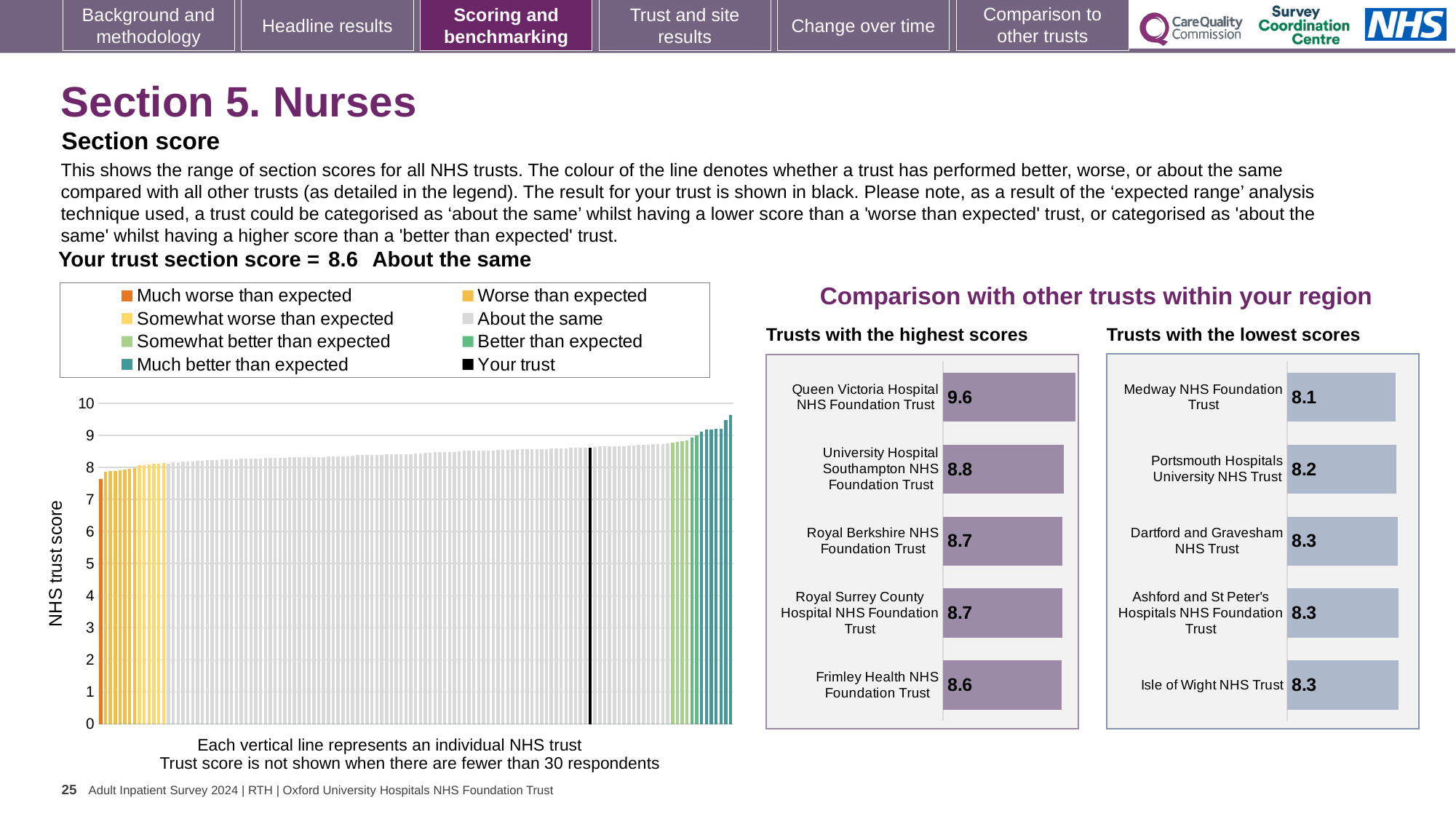
How many entries does the legend of the main section score chart on the left list? 8 In the main section score chart on the left, is the value for 'Your trust' (the black line) greater or less than 8? greater In the 'Trusts with the highest scores' chart, which trust has the highest score? Queen Victoria Hospital NHS Foundation Trust In the 'Trusts with the highest scores' chart, what is the score for Frimley Health NHS Foundation Trust? 8.6 In the main section score chart on the left, do the trust scores rise or fall from left to right along the x axis? rise In the 'Trusts with the lowest scores' chart, what is the score for Medway NHS Foundation Trust? 8.1 In the 'Trusts with the highest scores' chart, what is the score for Queen Victoria Hospital NHS Foundation Trust? 9.6 In the 'Trusts with the lowest scores' chart, what is the score for Portsmouth Hospitals University NHS Trust? 8.2 In the 'Trusts with the highest scores' chart, what is the difference between the scores of Queen Victoria Hospital NHS Foundation Trust and University Hospital Southampton NHS Foundation Trust? 0.8 In the 'Trusts with the lowest scores' chart, which has the larger score: Medway NHS Foundation Trust or Dartford and Gravesham NHS Trust? Dartford and Gravesham NHS Trust In the 'Trusts with the highest scores' chart, how many trusts are shown? 5 In the 'Trusts with the lowest scores' chart, which trust has the lowest score? Medway NHS Foundation Trust